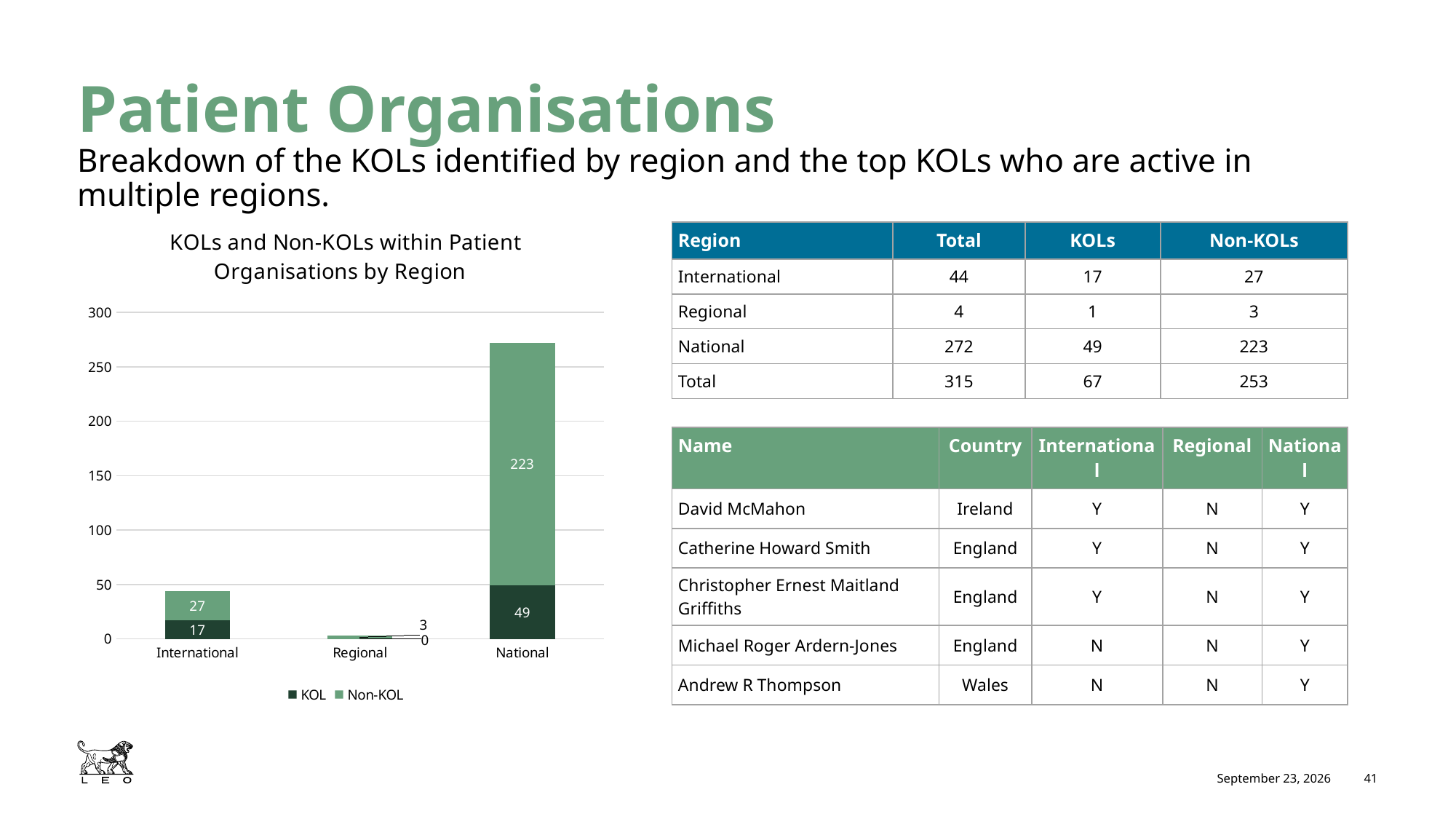
How many series does the chart legend list? 2 What is the Non-KOL value for International in the chart? 27 What is the KOL value for National in the chart? 49 What is the difference between the Non-KOL values for National and International in the chart? 196 Which region has the highest Non-KOL value in the chart? National What is the Non-KOL value for Regional in the chart? 3 Is the KOL value for National greater or less than 50? less What is the KOL value for International in the chart? 17 What type of chart is shown on the slide? Stacked bar chart What is the total height of the stacked bar for National in the chart? 272 Which region has the lowest Non-KOL value in the chart? Regional What is the Non-KOL value for National in the chart? 223